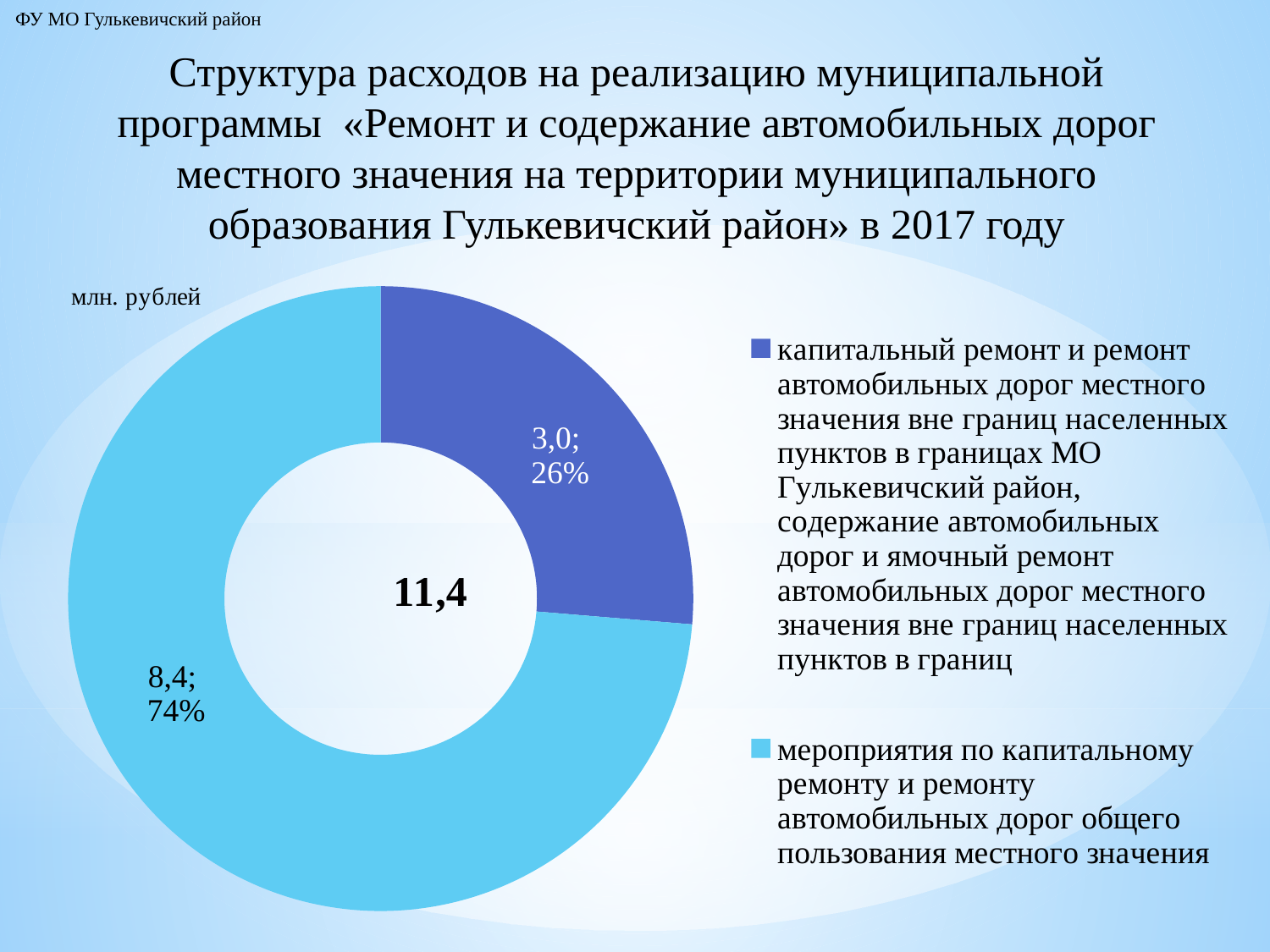
What share of the chart does the slice for «мероприятия по капитальному ремонту и ремонту автомобильных дорог общего пользования местного значения» represent? 74% Which is larger: the slice for «мероприятия по капитальному ремонту...» or the slice for «капитальный ремонт и ремонт автомобильных дорог местного значения вне границ населенных пунктов...»? мероприятия по капитальному ремонту и ремонту автомобильных дорог общего пользования местного значения What share of the chart does the slice for «капитальный ремонт и ремонт автомобильных дорог местного значения вне границ населенных пунктов...» represent? 26% What unit of measurement is indicated next to the chart? млн. рублей Which category has the largest slice? мероприятия по капитальному ремонту и ремонту автомобильных дорог общего пользования местного значения What is the value for «мероприятия по капитальному ремонту и ремонту автомобильных дорог общего пользования местного значения»? 8,4 What is the value for «капитальный ремонт и ремонт автомобильных дорог местного значения вне границ населенных пунктов...»? 3,0 What total value is shown in the centre of the doughnut chart? 11,4 What is the difference between the two slice values, 8,4 and 3,0? 5,4 What type of chart is shown on the slide? Doughnut (pie) chart How many slices does the chart have? 2 Which category has the smallest slice? капитальный ремонт и ремонт автомобильных дорог местного значения вне границ населенных пунктов в границах МО Гулькевичский район...